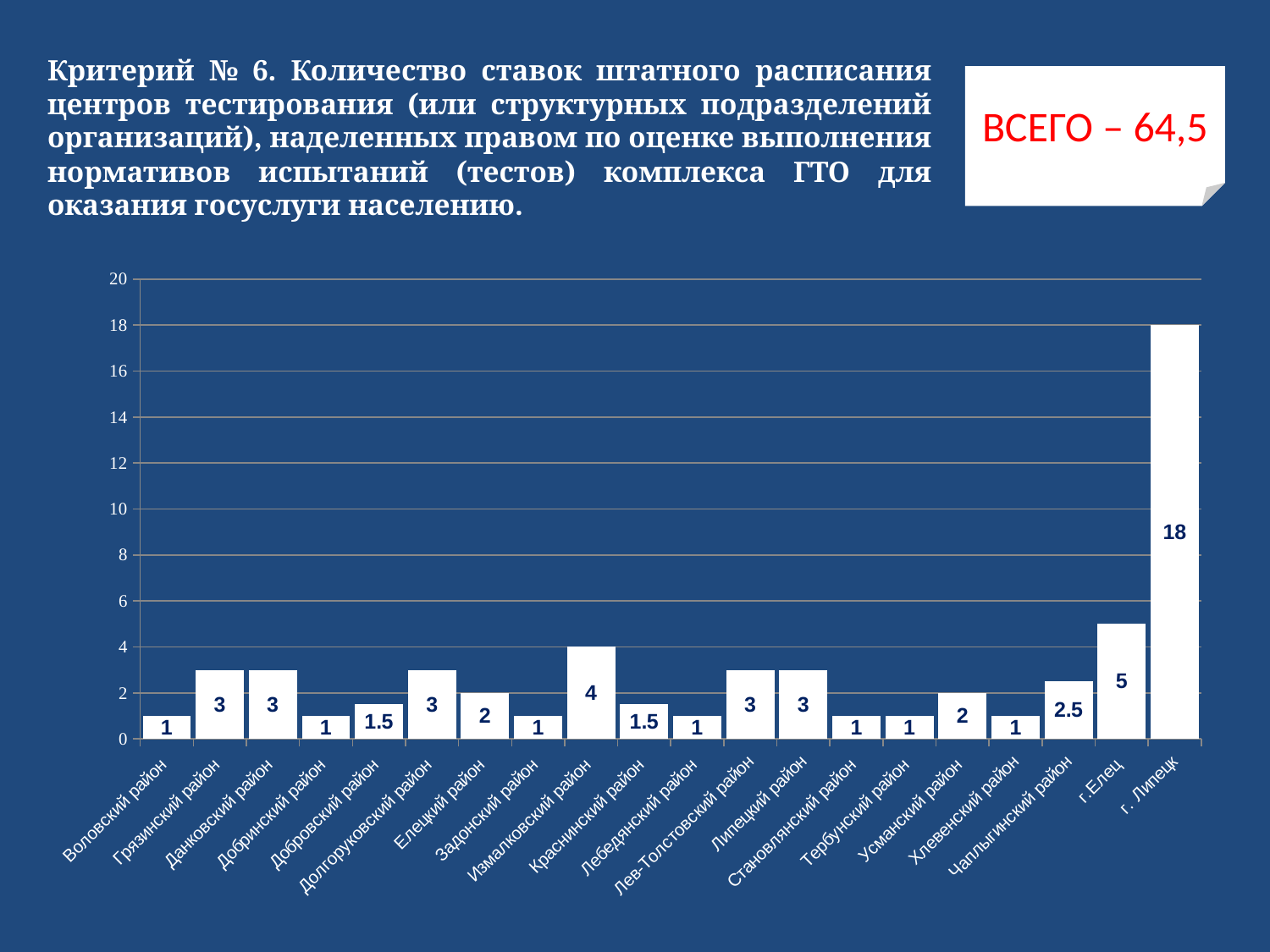
What is the value for г.Елец? 5 What is the value for Добровский район? 1.5 What is the value for Измалковский район? 4 What is the value for г. Липецк? 18 Is the value for г. Липецк greater or less than 16? greater What total value is shown in the box at the top right of the slide? 64,5 What is the difference between the values for г. Липецк and г.Елец? 13 Which category has the highest value? г. Липецк How many categories are shown on the x axis? 20 What type of chart is shown on the slide? bar chart Which is larger, the value for Измалковский район or the value for Усманский район? Измалковский район What is the value for Чаплыгинский район? 2.5